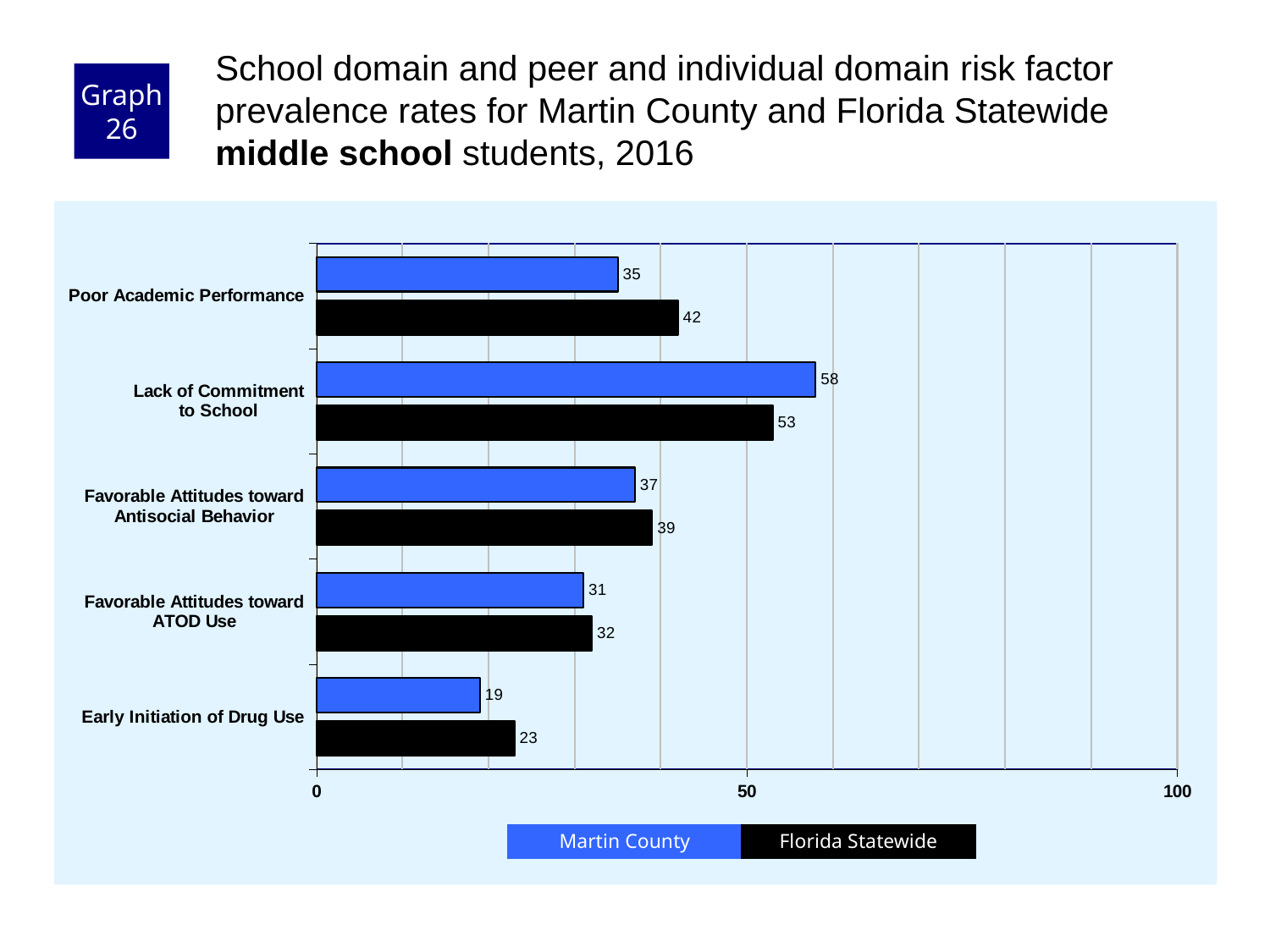
What is the Florida Statewide value for Early Initiation of Drug Use? 23 Which risk factor has the lowest Florida Statewide value? Early Initiation of Drug Use What is the Martin County value for Lack of Commitment to School? 58 How many series does the legend list? 2 How many risk factor categories are shown on the chart? 5 What is the difference between the Florida Statewide and Martin County values for Poor Academic Performance? 7 Is the Martin County value for Early Initiation of Drug Use greater or less than 50? less Which colour represents Florida Statewide in the chart? black Which risk factor has the highest Martin County value? Lack of Commitment to School For Lack of Commitment to School, which is larger: the Martin County value or the Florida Statewide value? Martin County What kind of chart is shown on the slide? bar chart What is the Florida Statewide value for Poor Academic Performance? 42